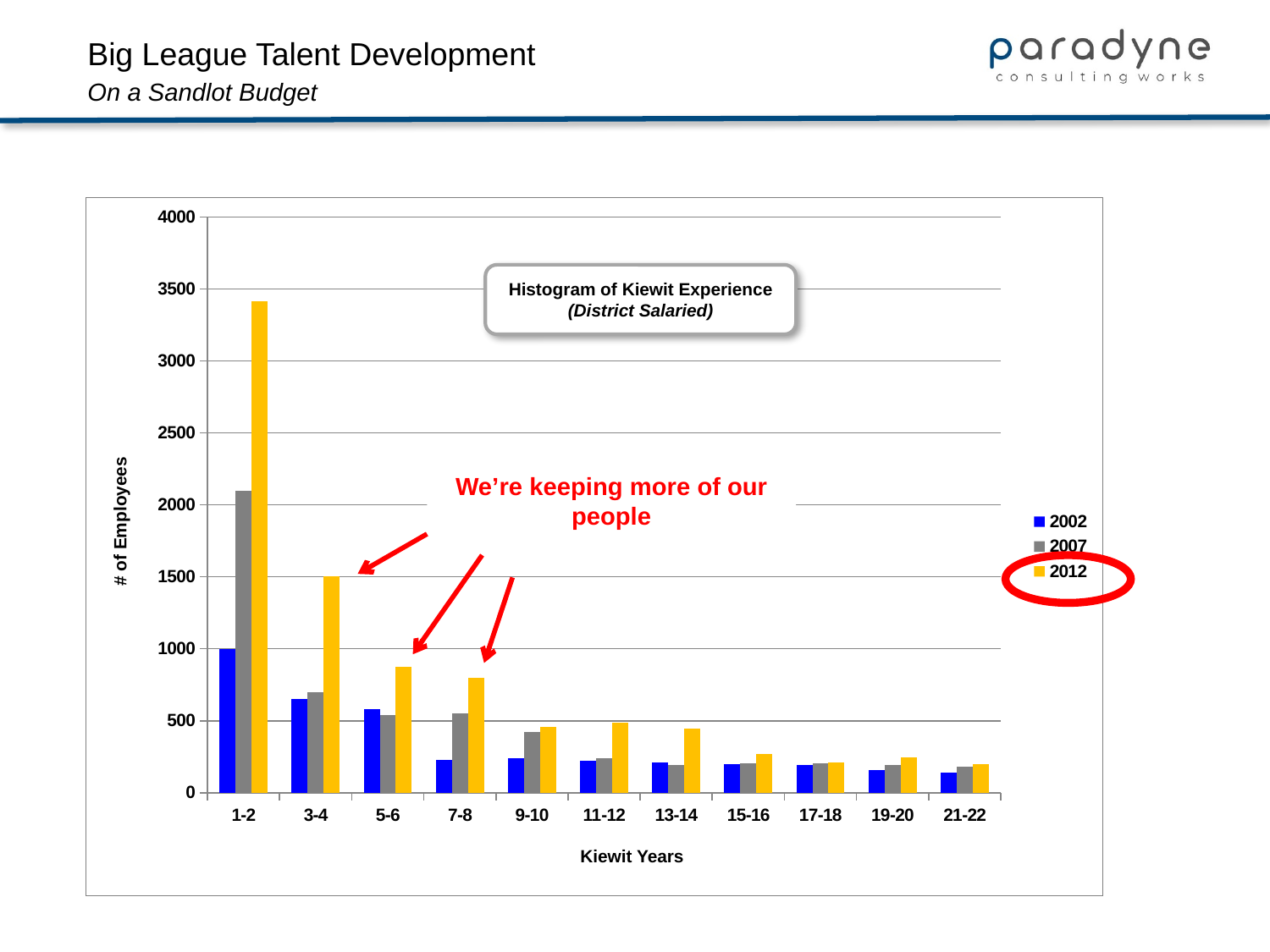
Do the 2012 values rise or fall as Kiewit Years increase along the x axis? fall What is the title of the chart? Histogram of Kiewit Experience (District Salaried) Is the 2012 value for 5-6 Kiewit Years greater or less than 1000? less Is the 2007 value for 1-2 Kiewit Years greater or less than 2000? greater For 1-2 Kiewit Years, which series has the larger value, 2002 or 2012? 2012 Which Kiewit Years category has the highest 2012 value? 1-2 What kind of chart is shown on the slide? bar chart How many series does the legend list? 3 Is the 2012 value for 1-2 Kiewit Years greater or less than 3000? greater How many Kiewit Years categories are shown on the x axis? 11